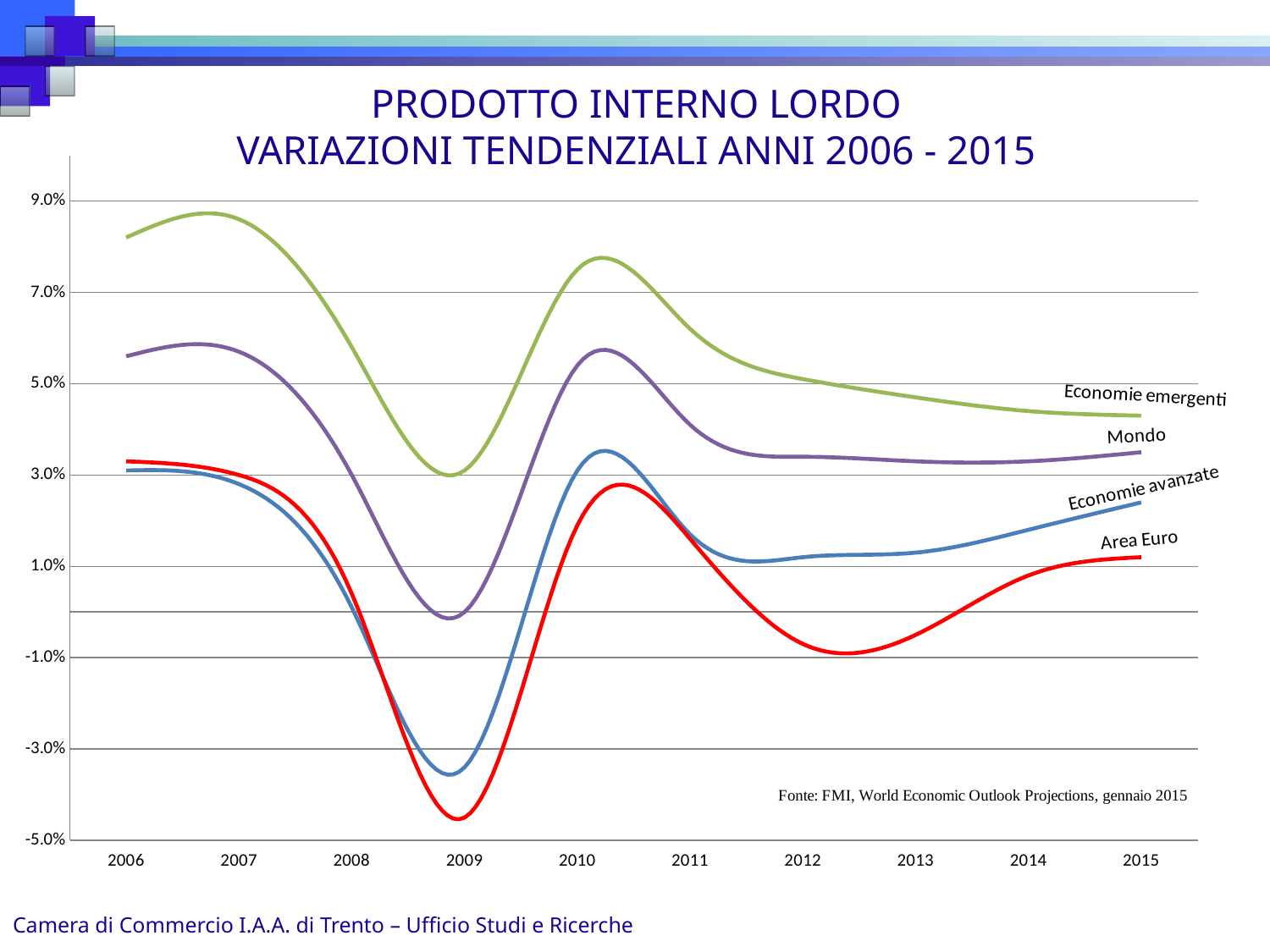
Is the value for Economie emergenti in 2006 greater or less than 7.0%? greater How many series are plotted on the chart? 4 In which year does the Area Euro series reach its lowest value? 2009 Is the value for Economie emergenti in 2015 greater or less than 5.0%? less Which series has the lowest value in 2009? Area Euro Does the Economie emergenti series rise or fall from 2010 to 2015? fall Which series has the highest value in 2006? Economie emergenti What is the title of the chart? PRODOTTO INTERNO LORDO VARIAZIONI TENDENZIALI ANNI 2006 - 2015 How many years are shown on the x axis? 10 In 2012, which is larger: the value for Economie avanzate or the value for Area Euro? Economie avanzate What kind of chart is shown on the slide? line chart Is the value for Area Euro in 2009 greater or less than -3.0%? less